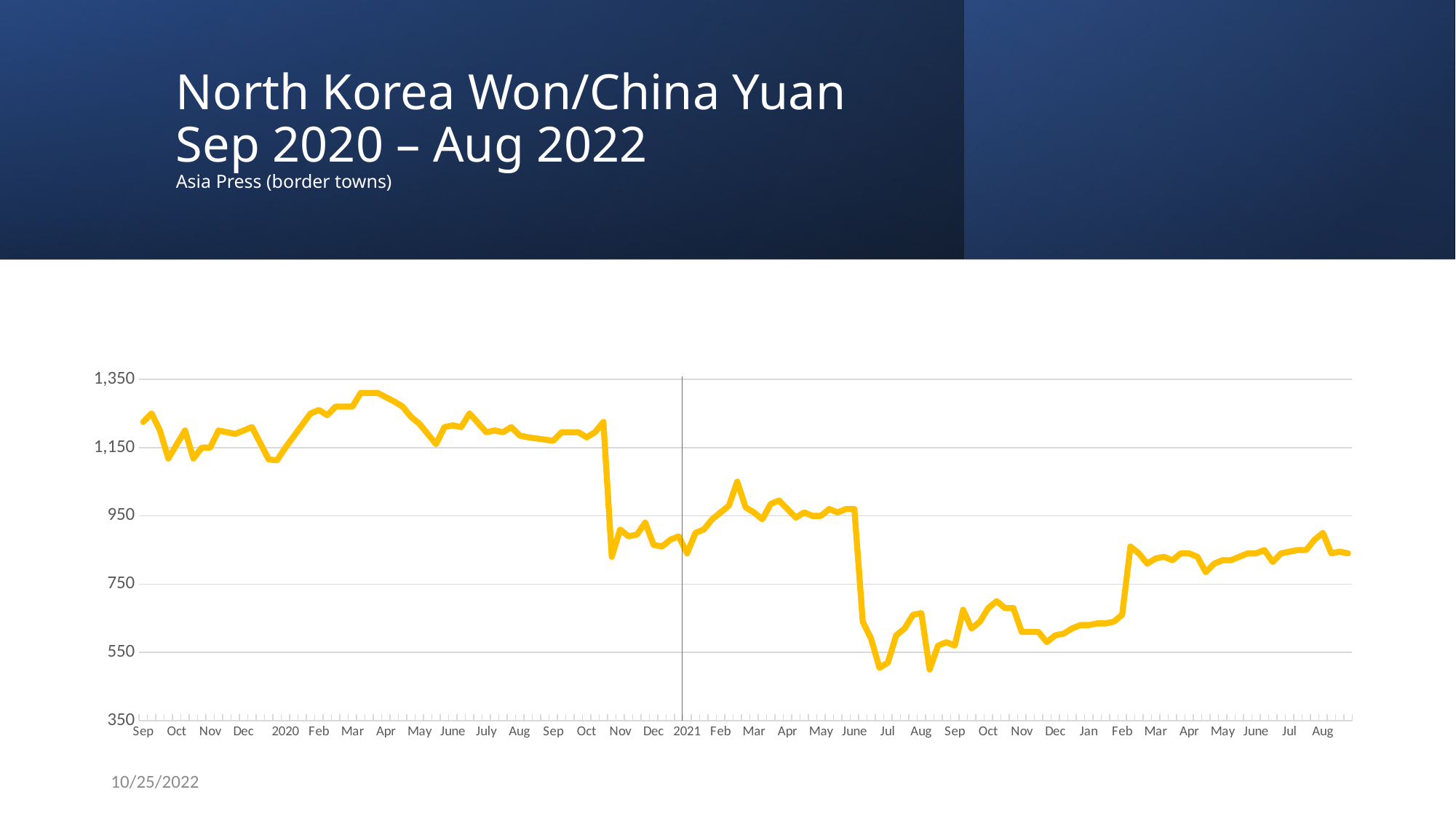
Is the value around Apr 2021 greater or less than 1,150? less Is the value at the start of the series (Sep 2020) greater or less than 1,150? greater What is the title of the chart on the slide? North Korea Won/China Yuan Sep 2020 – Aug 2022 How many lines (series) are plotted on the chart? 1 What is the highest value shown on the vertical axis? 1,350 What kind of chart is shown on the slide? line chart What source is given beneath the chart title? Asia Press (border towns) Overall, do the values rise or fall from Sep 2020 to Aug 2022? fall Is the value at the end of the series (Aug 2022) greater or less than 750? greater